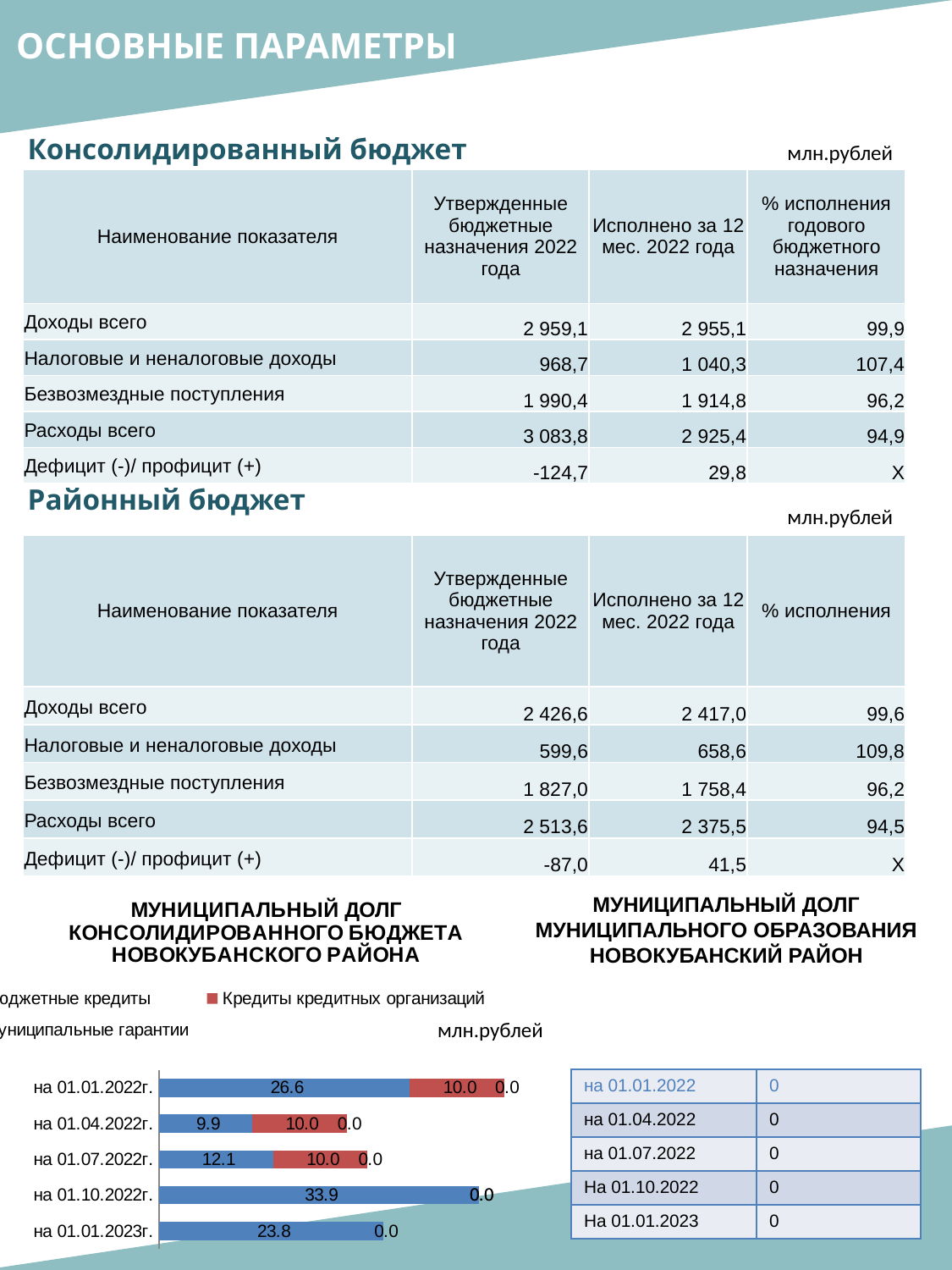
In the municipal debt bar chart, what is the value of the blue segment на 01.10.2022г.? 33.9 In the municipal debt bar chart, what is the value of 'Кредиты кредитных организаций' на 01.07.2022г.? 10.0 In the municipal debt bar chart, what is the value of 'Кредиты кредитных организаций' на 01.01.2022г.? 10.0 What kind of chart is shown under the title 'МУНИЦИПАЛЬНЫЙ ДОЛГ КОНСОЛИДИРОВАННОГО БЮДЖЕТА НОВОКУБАНСКОГО РАЙОНА'? bar chart How many series does the legend of the municipal debt bar chart list? 3 In the municipal debt bar chart, on which date is the blue segment the smallest? на 01.04.2022г. In the municipal debt bar chart, which is larger: the blue segment на 01.07.2022г. or на 01.04.2022г.? на 01.07.2022г. In the municipal debt bar chart, on which date is the blue segment the largest? на 01.10.2022г. In the municipal debt bar chart, what is the total of the stacked bar на 01.01.2022г.? 36.6 In the municipal debt bar chart, what is the difference between the blue segment на 01.10.2022г. and на 01.01.2023г.? 10.1 How many dates (categories) are plotted in the municipal debt bar chart? 5 In the municipal debt bar chart, what colour represents 'Кредиты кредитных организаций'? red